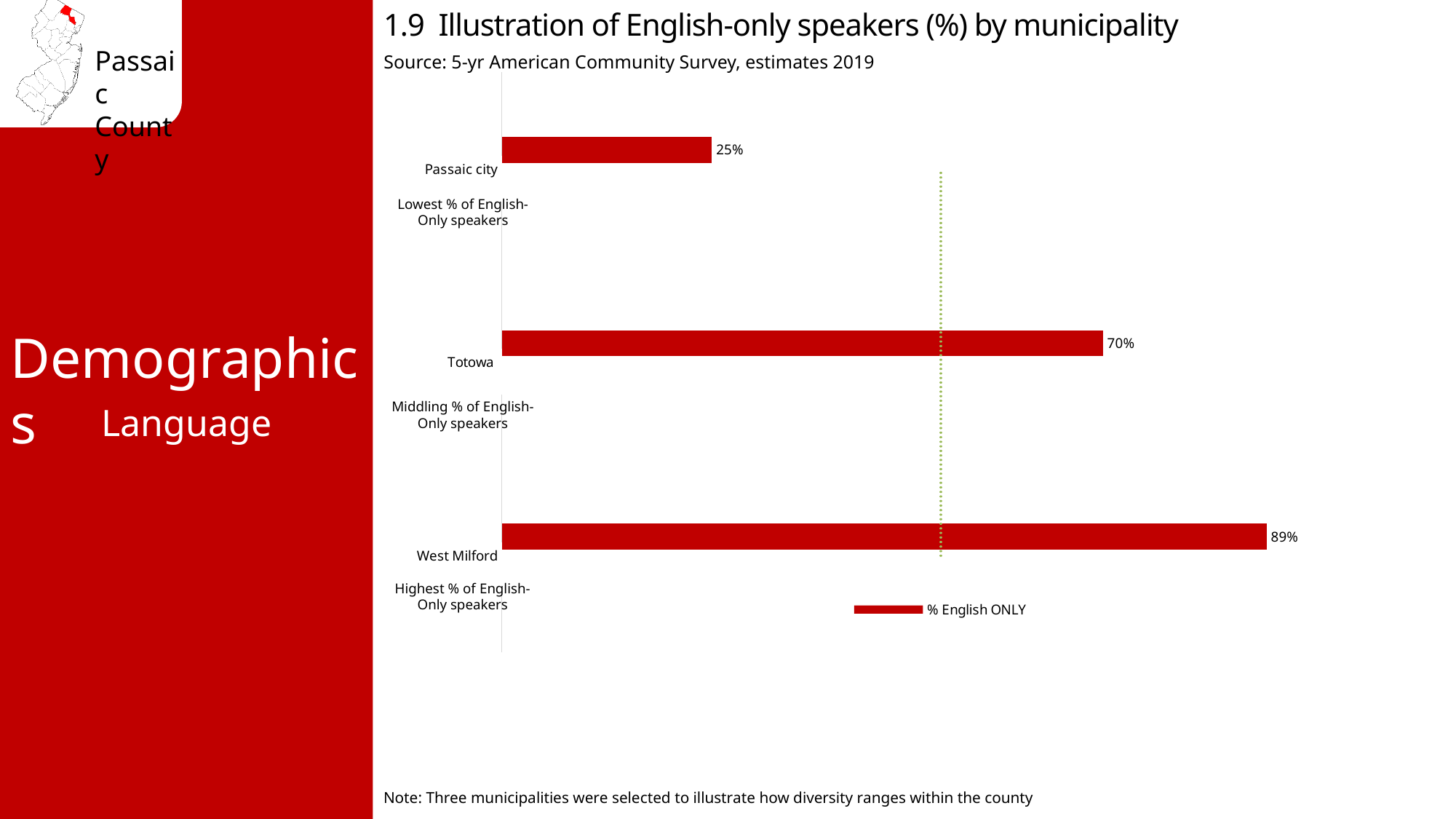
What is the percentage of English-only speakers in Totowa? 70% Which has a higher percentage of English-only speakers, Totowa or Passaic city? Totowa What is the difference in percentage points between West Milford and Passaic city? 64 How many series does the legend list? 1 What is the percentage of English-only speakers in Passaic city? 25% What is the legend entry for the series in the chart? % English ONLY Which municipality has the highest percentage of English-only speakers? West Milford How many municipalities are shown in the chart? 3 Which municipality has the lowest percentage of English-only speakers? Passaic city What is the difference in percentage points between West Milford and Totowa? 19 What is the percentage of English-only speakers in West Milford? 89% What kind of chart is shown on the slide? Bar chart